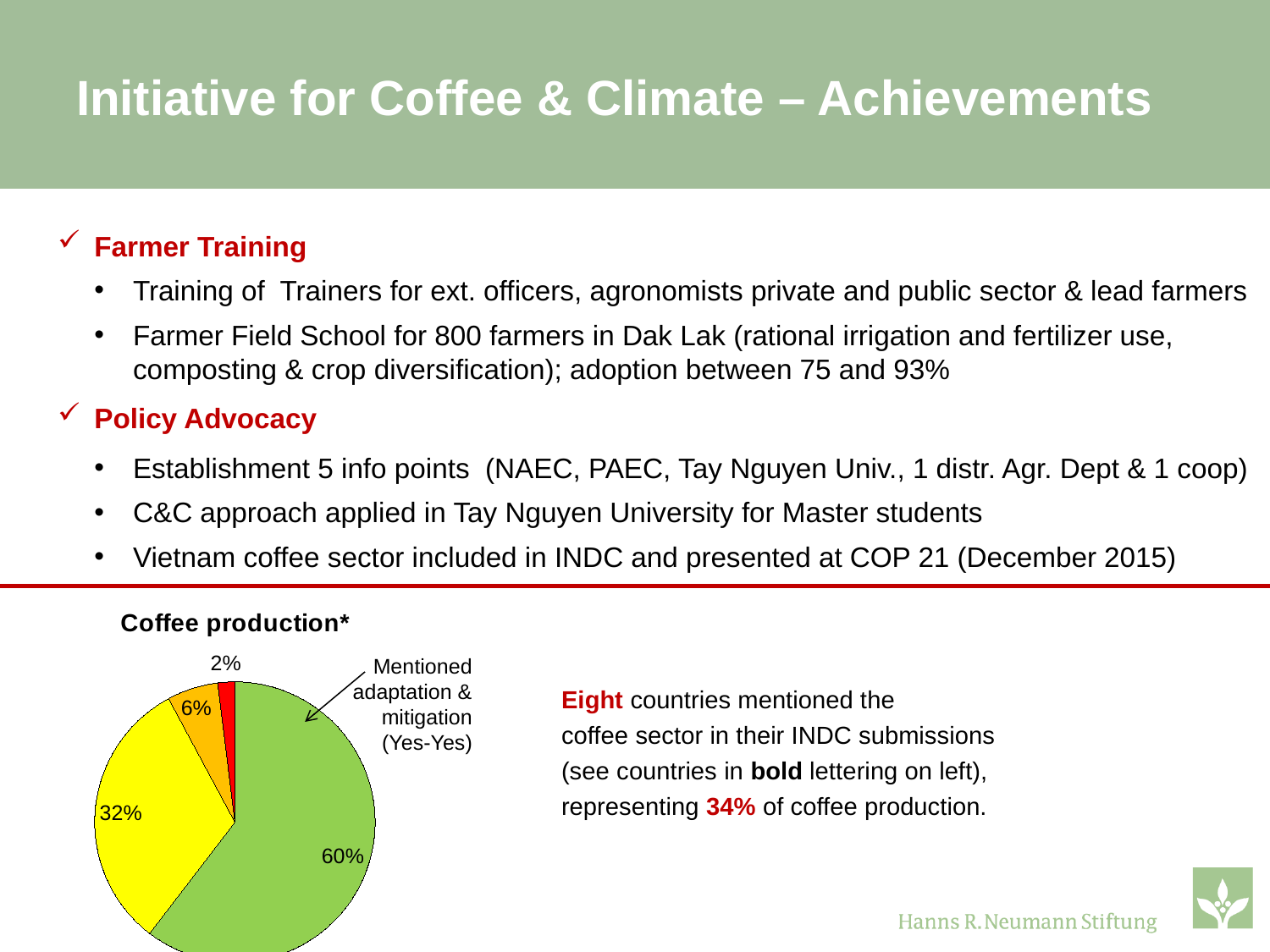
In the "Coffee production*" pie chart, which is larger: the green slice or the yellow slice? the green slice In the "Coffee production*" pie chart, what is the value of the orange slice? 6% In the "Coffee production*" pie chart, what is the value of the yellow slice? 32% What kind of chart is shown under the heading "Coffee production*"? pie chart In the "Coffee production*" pie chart, what is the difference in percentage points between the 60% slice and the 32% slice? 28 In the "Coffee production*" pie chart, what is the combined share of the 6% and 2% slices? 8% How many slices does the "Coffee production*" pie chart have? 4 What is the value of the largest slice in the "Coffee production*" pie chart? 60% In the "Coffee production*" pie chart, what colour is the slice labelled "Mentioned adaptation & mitigation (Yes-Yes)"? green In the "Coffee production*" pie chart, what share is labelled "Mentioned adaptation & mitigation (Yes-Yes)"? 60% What is the value of the smallest slice in the "Coffee production*" pie chart? 2% What is the title of the pie chart on the slide? Coffee production*